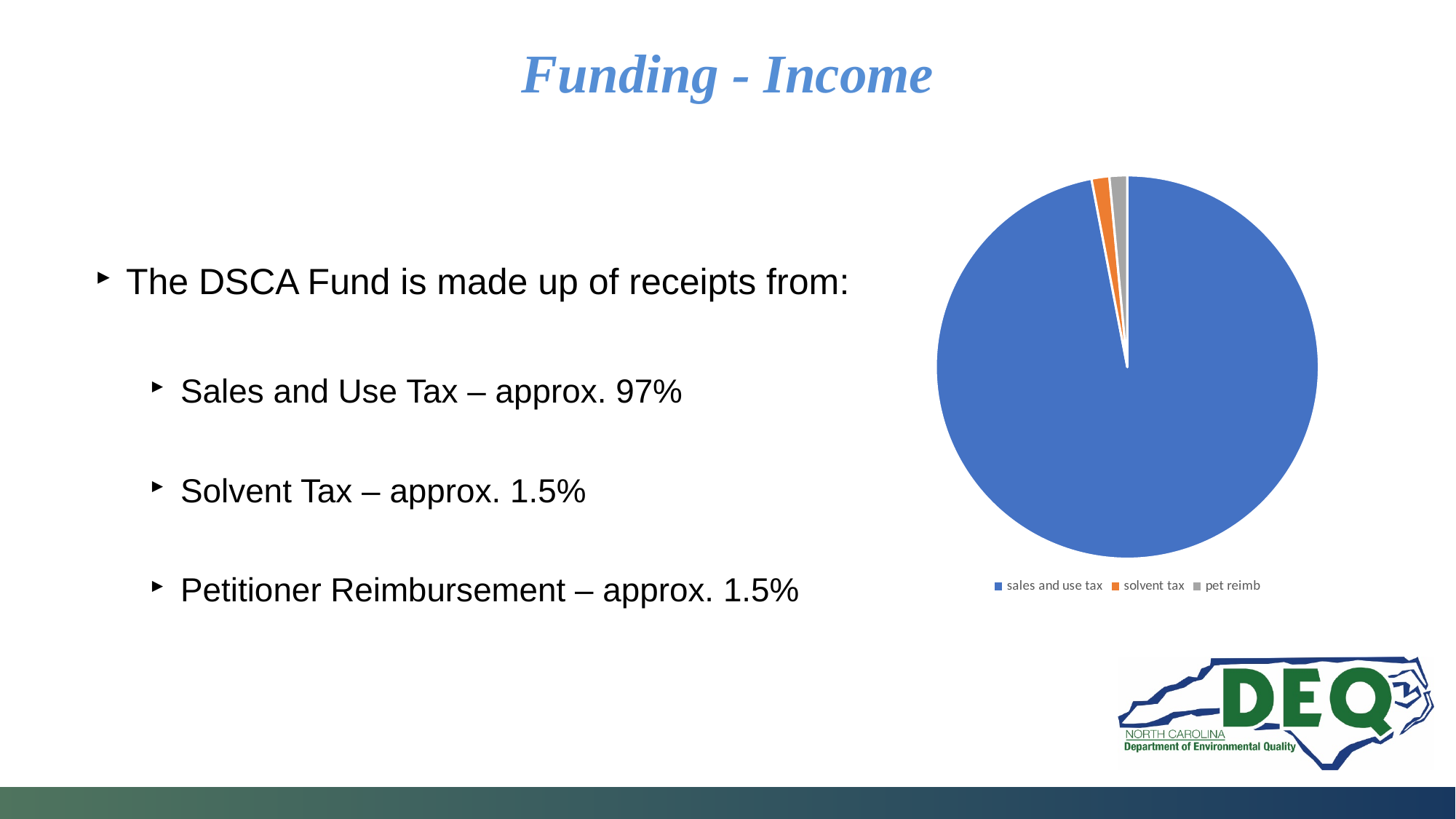
Which legend entry in the pie chart is shown in orange? solvent tax Which is larger in the pie chart, sales and use tax or solvent tax? sales and use tax What kind of chart is shown on the slide? pie chart Which is larger in the pie chart, sales and use tax or pet reimb? sales and use tax How many entries does the pie chart's legend list? 3 What colour is the sales and use tax slice in the pie chart? blue Which slice of the pie chart is the largest? sales and use tax How many slices does the pie chart have? 3